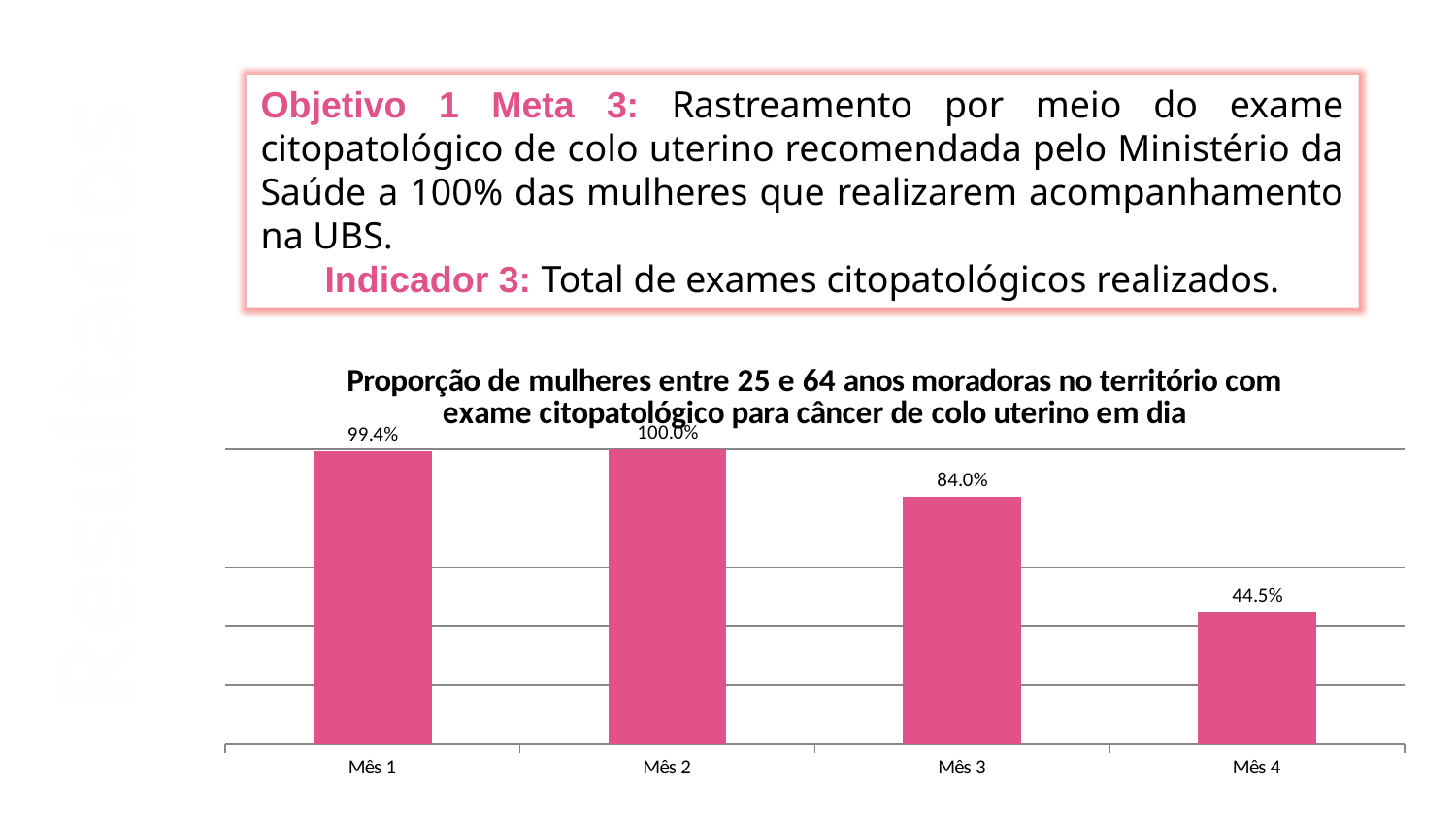
What is the difference between the values for Mês 3 and Mês 4? 39.5% Which month has the lowest value? Mês 4 What is the difference between the values for Mês 2 and Mês 3? 16.0% What is the value for Mês 2? 100.0% What is the value for Mês 4? 44.5% Do the values rise or fall from Mês 2 to Mês 4? Fall How many months are shown on the x axis? 4 What kind of chart is shown on the slide? Bar chart What is the value for Mês 3? 84.0% Which is larger, the value for Mês 1 or the value for Mês 3? Mês 1 Which month has the highest value? Mês 2 What is the value for Mês 1? 99.4%